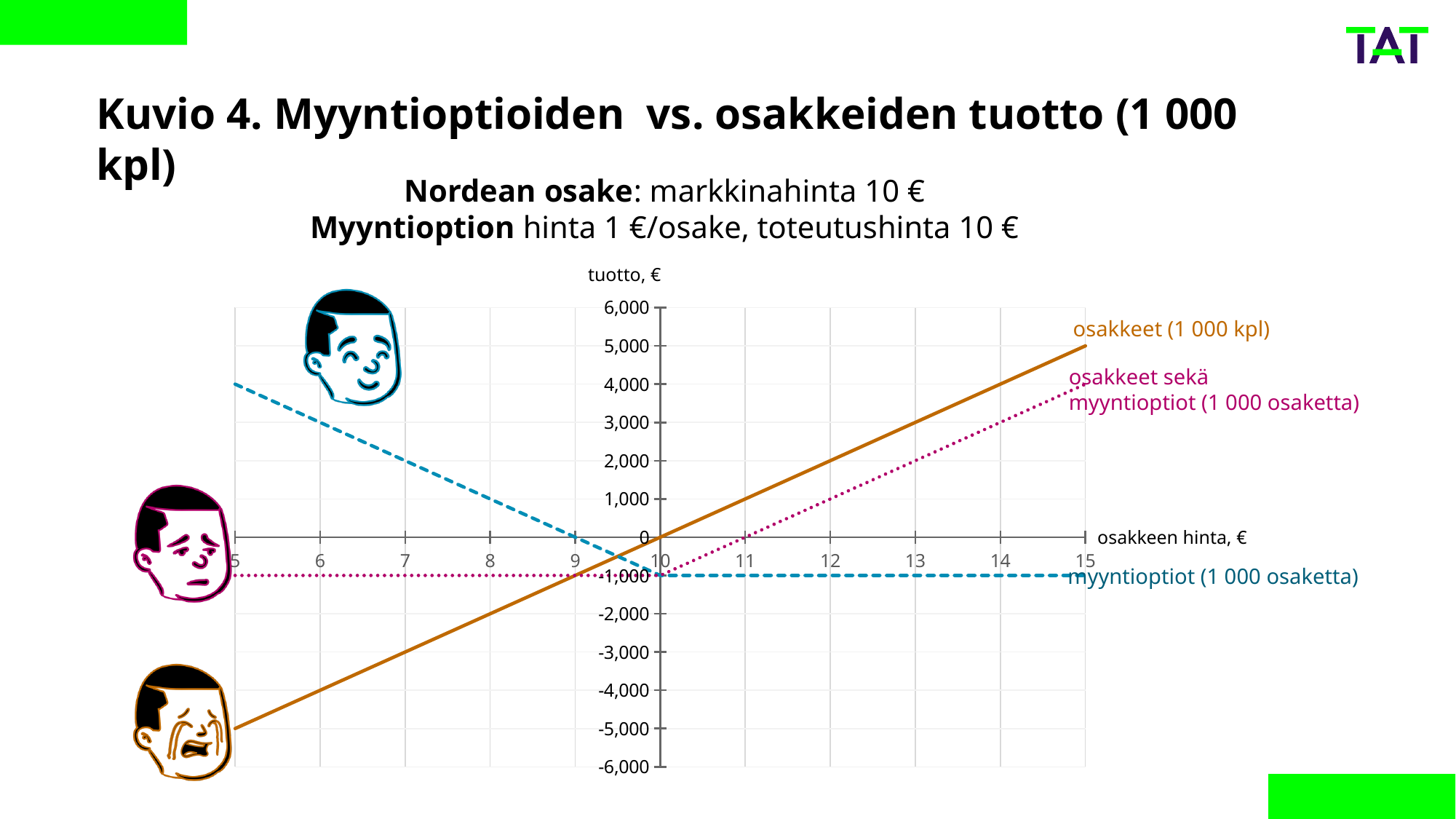
How many series are plotted on the chart? 3 At an osakkeen hinta of 15, what is the difference between the tuotto of osakkeet (1 000 kpl) and osakkeet sekä myyntioptiot (1 000 osaketta)? 1,000 What kind of chart is shown on the slide? line chart What is the tuotto for myyntioptiot (1 000 osaketta) when the osakkeen hinta is 12? -1,000 Does the tuotto for osakkeet (1 000 kpl) rise or fall as the osakkeen hinta increases? rise What is the tuotto for myyntioptiot (1 000 osaketta) when the osakkeen hinta is 5? 4,000 What is the tuotto for osakkeet sekä myyntioptiot (1 000 osaketta) when the osakkeen hinta is 15? 4,000 At an osakkeen hinta of 7, which series has the higher tuotto: osakkeet (1 000 kpl) or myyntioptiot (1 000 osaketta)? myyntioptiot (1 000 osaketta) Is the tuotto for osakkeet (1 000 kpl) at an osakkeen hinta of 13 greater or less than 2,000? greater What is the label of the vertical axis of the chart? tuotto, € What is the tuotto for osakkeet (1 000 kpl) when the osakkeen hinta is 5? -5,000 What is the tuotto for osakkeet (1 000 kpl) when the osakkeen hinta is 15? 5,000